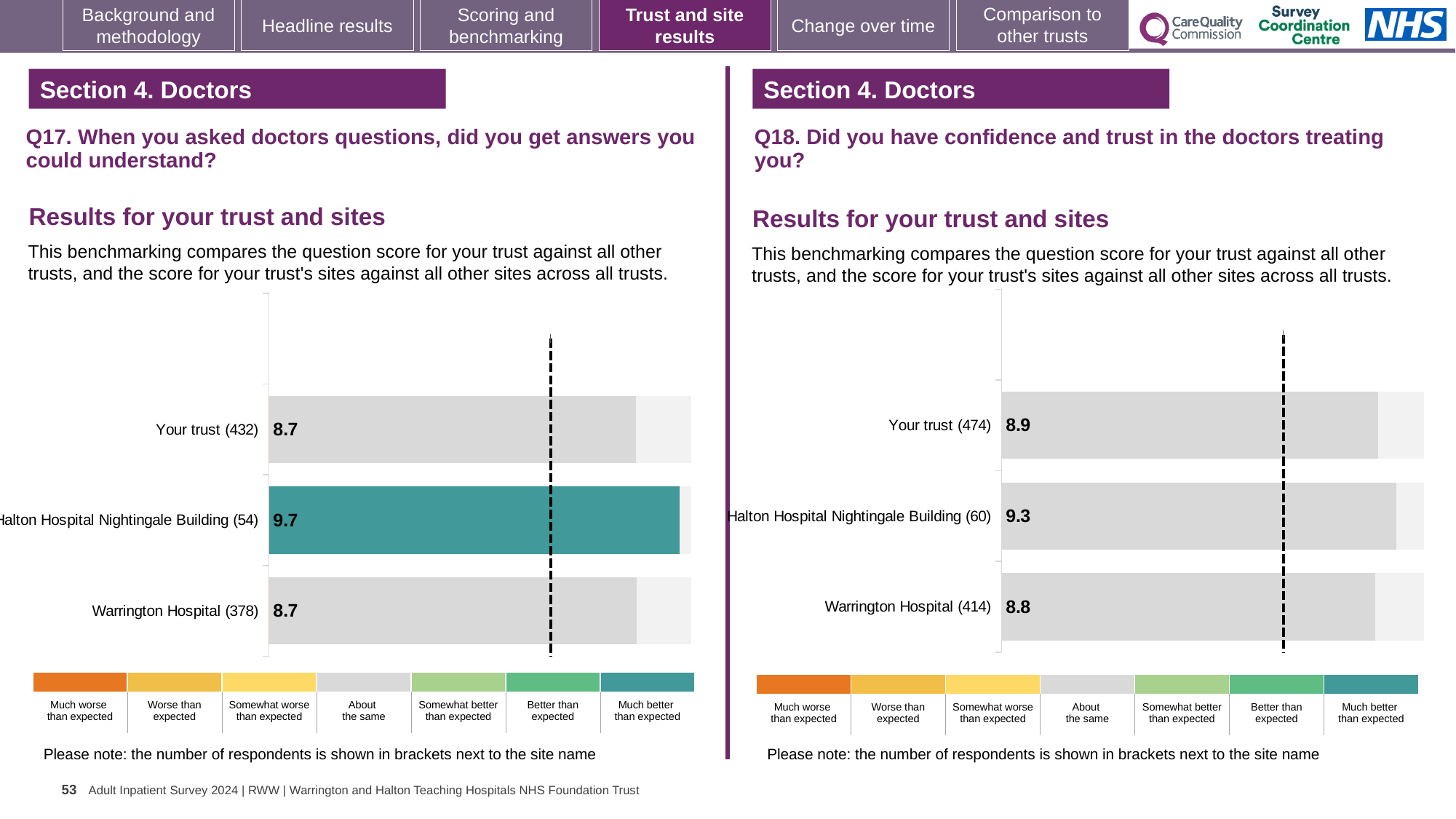
In the Q17 chart on the left, what is the difference between the scores for Halton Hospital Nightingale Building (54) and Warrington Hospital (378)? 1.0 In the Q18 chart on the right, is the score for Halton Hospital Nightingale Building (60) higher or lower than the score for Your trust (474)? higher In the Q18 chart on the right, which site or trust has the lowest score? Warrington Hospital (414) In the Q17 chart on the left, how many bars are plotted? 3 In the Q18 chart on the right, what is the difference between the scores for Halton Hospital Nightingale Building (60) and Your trust (474)? 0.4 In the Q17 chart on the left, what is the score for Halton Hospital Nightingale Building (54)? 9.7 In the Q17 chart on the left, which benchmark category does the colour of the Halton Hospital Nightingale Building bar indicate? Much better than expected In the Q17 chart on the left, what is the score for Your trust (432)? 8.7 What type of chart is used for the Q18 results on the right? bar chart In the Q17 chart on the left, which site or trust has the highest score? Halton Hospital Nightingale Building (54) In the Q18 chart on the right, what is the score for Your trust (474)? 8.9 In the Q18 chart on the right, what is the score for Warrington Hospital (414)? 8.8